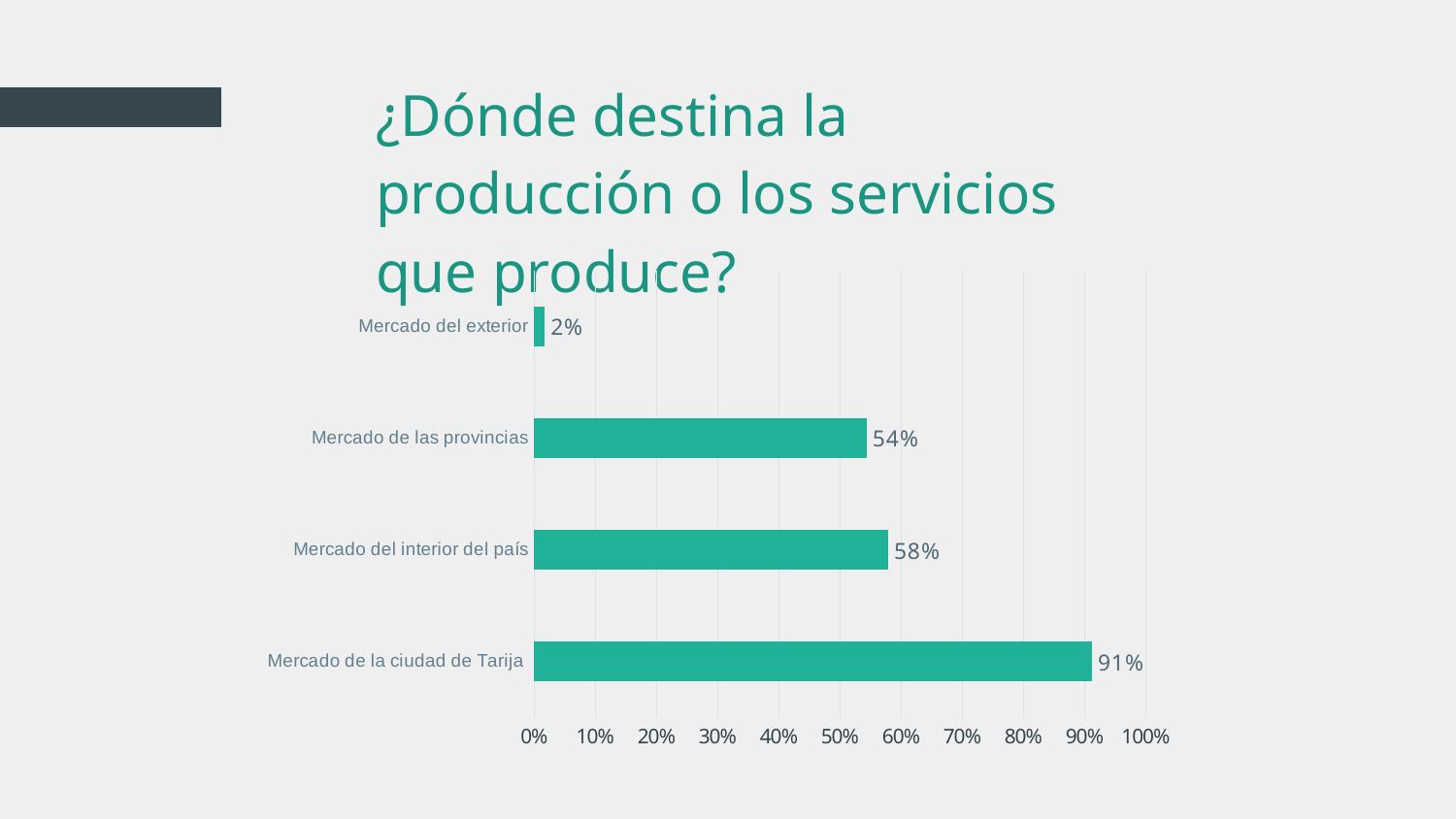
What is the value for Mercado del interior del país? 58% What is the value for Mercado de las provincias? 54% How many categories are shown in the chart? 4 What is the difference between the values for Mercado del interior del país and Mercado de las provincias? 4% Which category has the lowest value? Mercado del exterior What is the value for Mercado del exterior? 2% Is the value for Mercado de la ciudad de Tarija greater or less than 80%? greater Which category has the highest value? Mercado de la ciudad de Tarija Which is larger, the value for Mercado de las provincias or the value for Mercado del exterior? Mercado de las provincias What is the value for Mercado de la ciudad de Tarija? 91% What is the difference between the values for Mercado de la ciudad de Tarija and Mercado del interior del país? 33% What kind of chart is shown on the slide? Bar chart